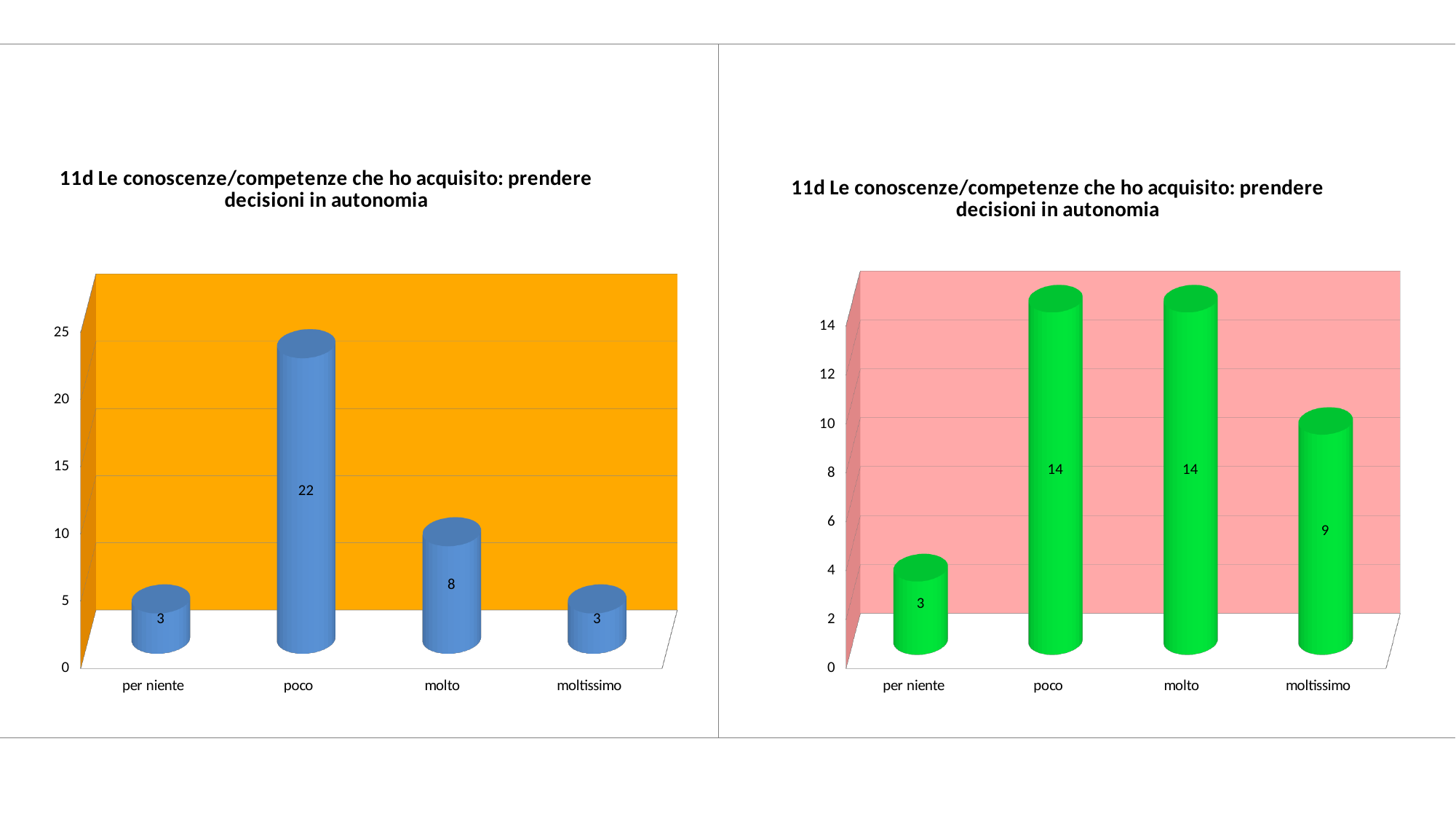
How many categories are shown on the x axis of the left chart? 4 In the right chart, is the value for 'moltissimo' larger or smaller than the value for 'poco'? smaller In the right chart, what is the value for 'per niente'? 3 In the left chart, what is the value for 'molto'? 8 What colour are the bars in the left chart? blue In the left chart, which category has the highest value? poco In the left chart, what is the value for 'poco'? 22 What kind of chart is the right chart? bar chart In the right chart, what is the difference between the values for 'molto' and 'moltissimo'? 5 In the left chart, what is the difference between the values for 'poco' and 'molto'? 14 In the right chart, which category has the lowest value? per niente In the right chart, what is the value for 'moltissimo'? 9